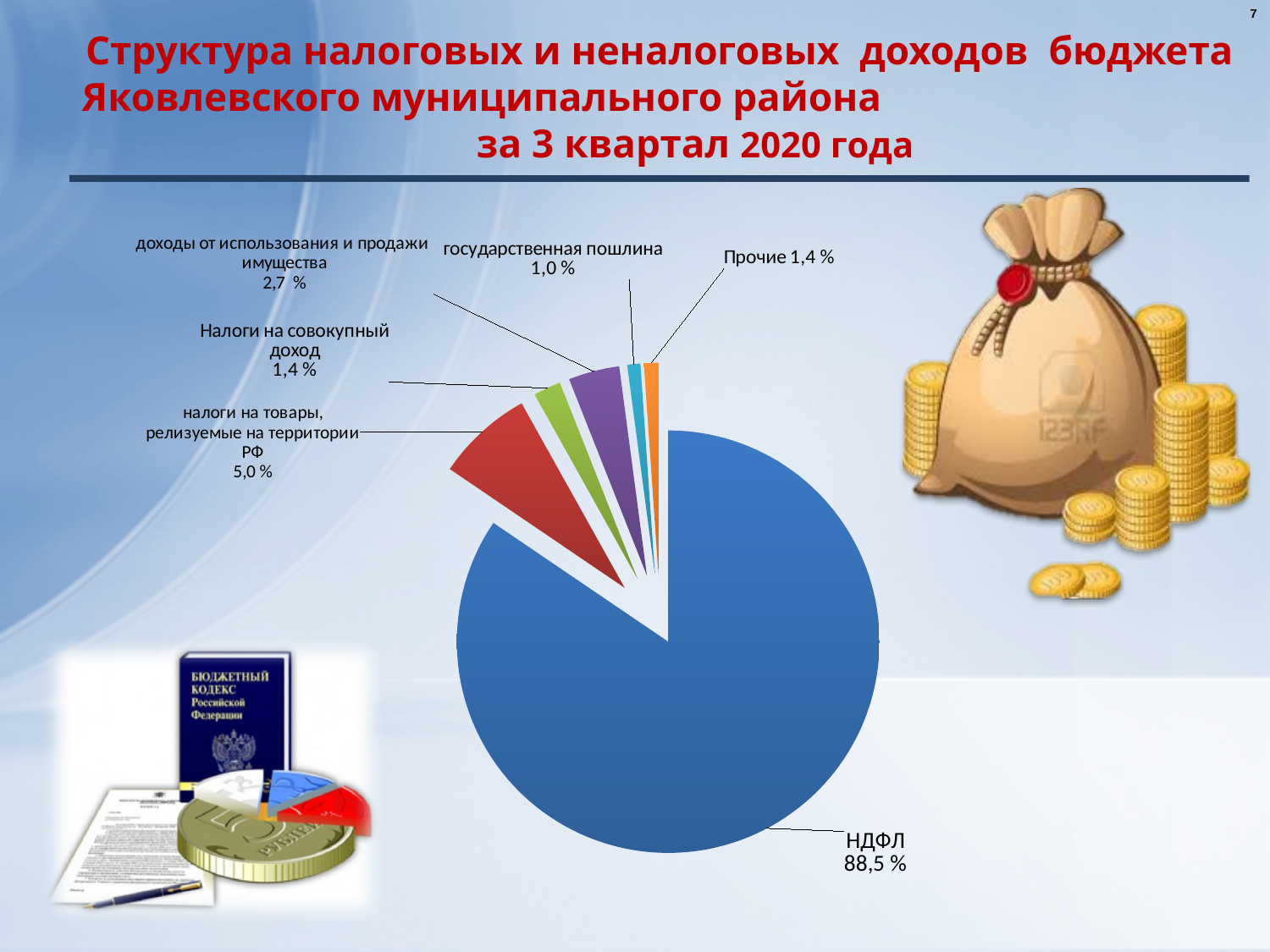
Which category has the smallest slice of the pie? государственная пошлина What colour is the НДФЛ slice of the pie? blue How many slices does the pie chart have? 6 What is the value shown for Налоги на совокупный доход? 1,4 % What share of the pie does НДФЛ account for? 88,5 % Which is larger: доходы от использования и продажи имущества or Прочие? доходы от использования и продажи имущества What kind of chart is shown on the slide? pie chart What is the value shown for налоги на товары, реализуемые на территории РФ? 5,0 % Which category has the largest slice of the pie? НДФЛ What is the difference between the share of НДФЛ and the share of налоги на товары, реализуемые на территории РФ? 83,5 % What is the value shown for государственная пошлина? 1,0 % What is the value shown for доходы от использования и продажи имущества? 2,7 %